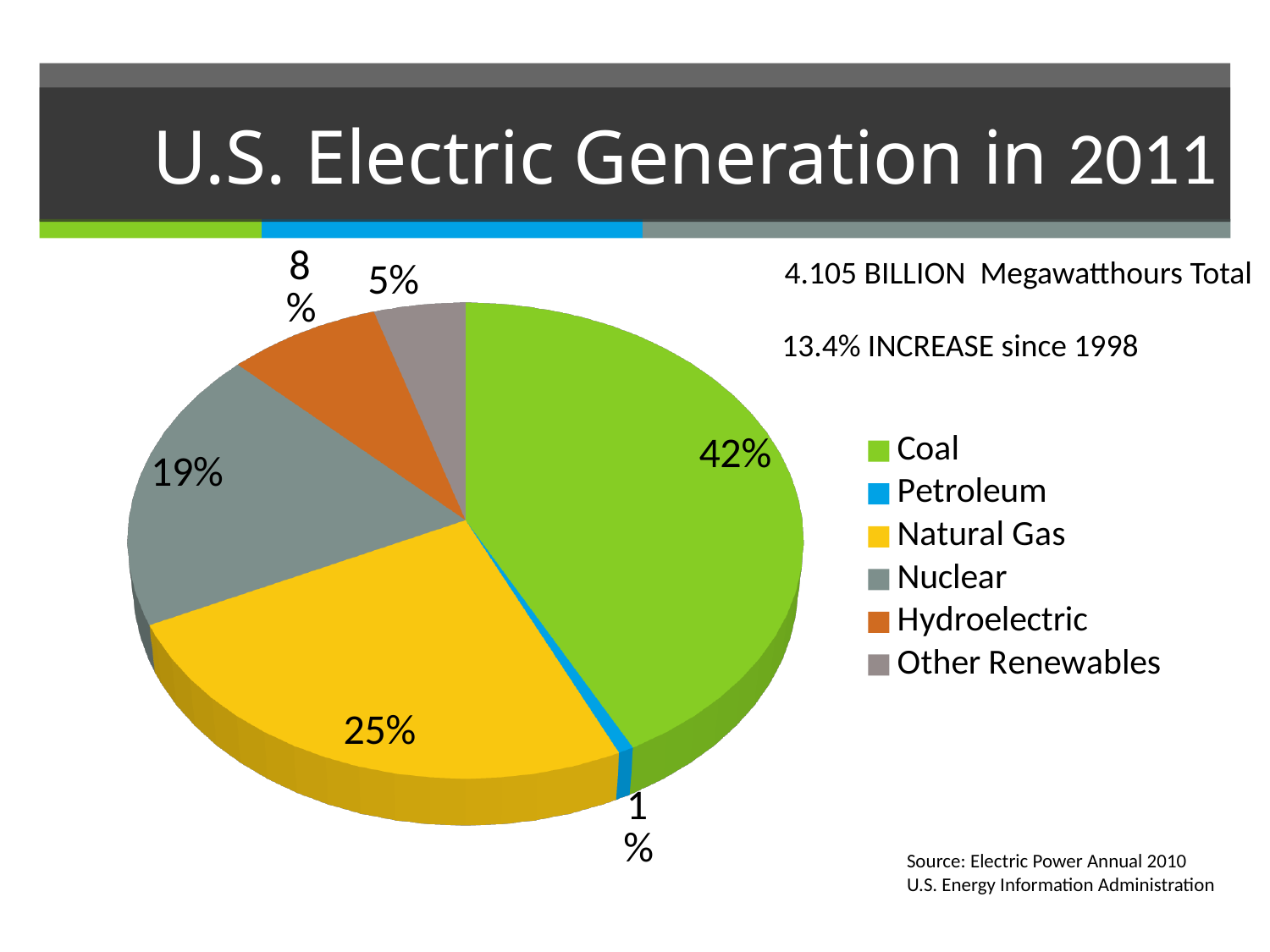
What share of U.S. electric generation in 2011 came from Hydroelectric? 8% Which energy source has the smallest share of the pie? Petroleum What share of U.S. electric generation in 2011 came from Other Renewables? 5% How many energy sources does the legend list? 6 Which energy source has the largest share of the pie? Coal What share of U.S. electric generation in 2011 came from Petroleum? 1% What share of U.S. electric generation in 2011 came from Coal? 42% What share of U.S. electric generation in 2011 came from Natural Gas? 25% What share of U.S. electric generation in 2011 came from Nuclear? 19% How many percentage points larger is the Coal share than the Natural Gas share? 17 Which has a larger share, Nuclear or Hydroelectric? Nuclear What kind of chart is shown on the slide? Pie chart